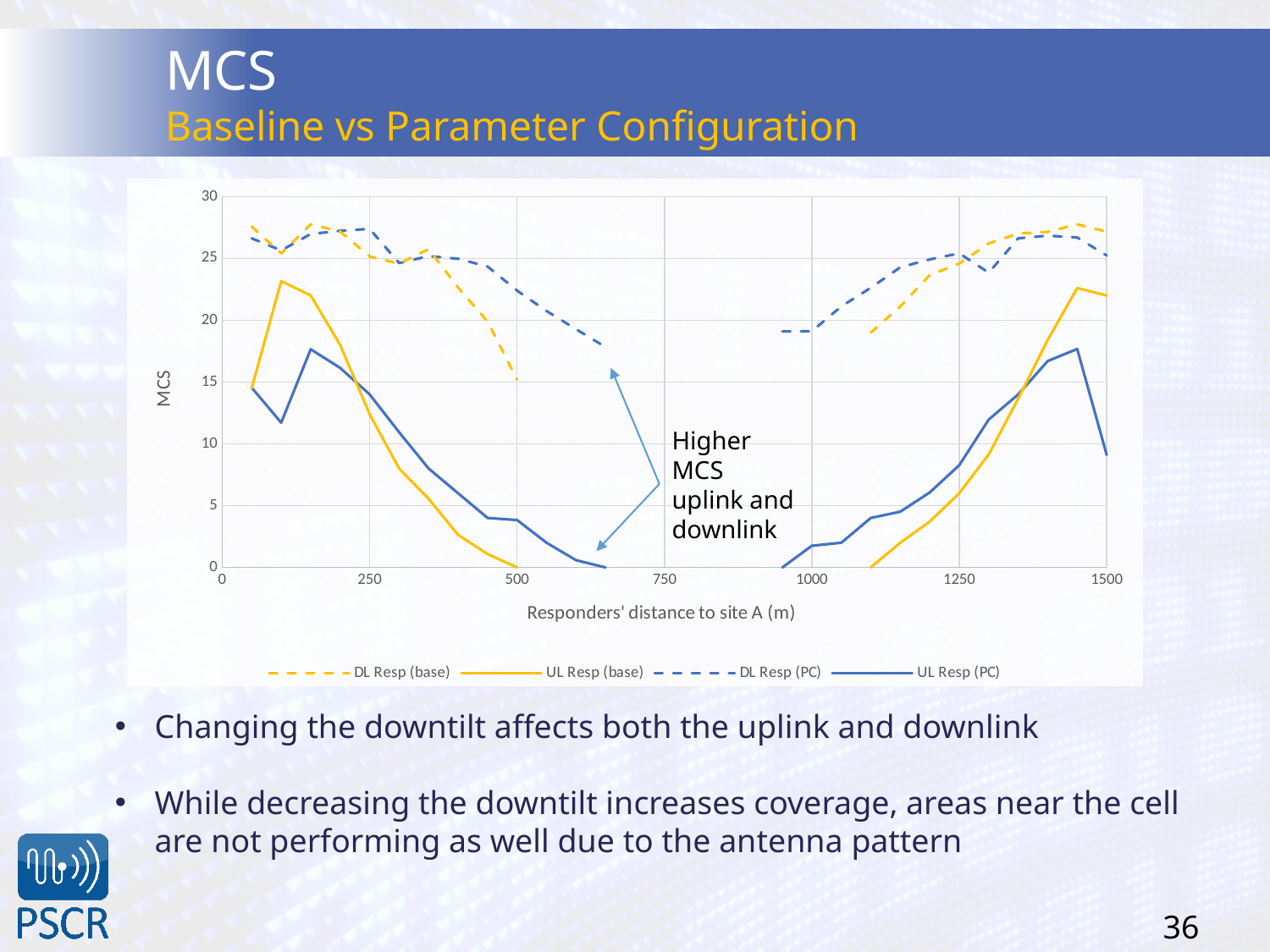
Is the value for UL Resp (PC) at 1500 m greater or less than 10? less Is the value for UL Resp (base) at 100 m greater or less than 20? greater Is the value for UL Resp (base) at 300 m greater or less than 10? less Does the UL Resp (PC) line rise or fall between 1000 m and 1450 m? rise What is the title of the x axis? Responders' distance to site A (m) What is the title of the y axis? MCS What kind of chart is shown on the slide? line chart How many series does the legend list? 4 At 100 m, which is larger: UL Resp (base) or UL Resp (PC)? UL Resp (base) Does the UL Resp (base) line rise or fall between 150 m and 500 m? fall